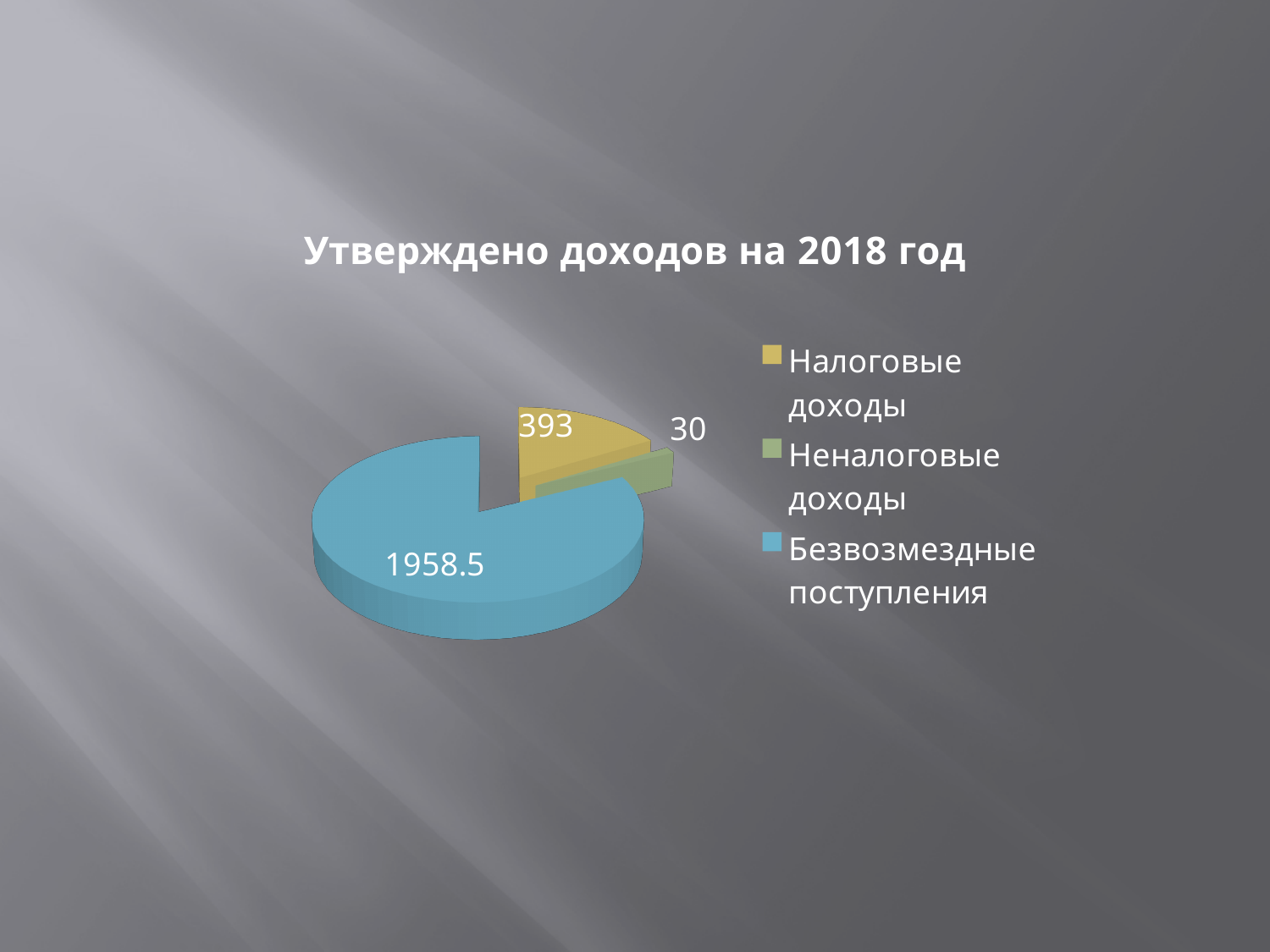
What is the value for Безвозмездные поступления? 1958.5 Which category has the smallest slice of the pie? Неналоговые доходы Which category has the largest slice of the pie? Безвозмездные поступления What is the value for Налоговые доходы? 393 What is the difference between the values for Налоговые доходы and Неналоговые доходы? 363 What kind of chart is shown on the slide? Pie chart What colour is the slice for Безвозмездные поступления? Blue How many slices does the pie chart have? 3 What is the title of the chart? Утверждено доходов на 2018 год What is the value for Неналоговые доходы? 30 What is the difference between the values for Безвозмездные поступления and Налоговые доходы? 1565.5 Which is larger, Налоговые доходы or Неналоговые доходы? Налоговые доходы